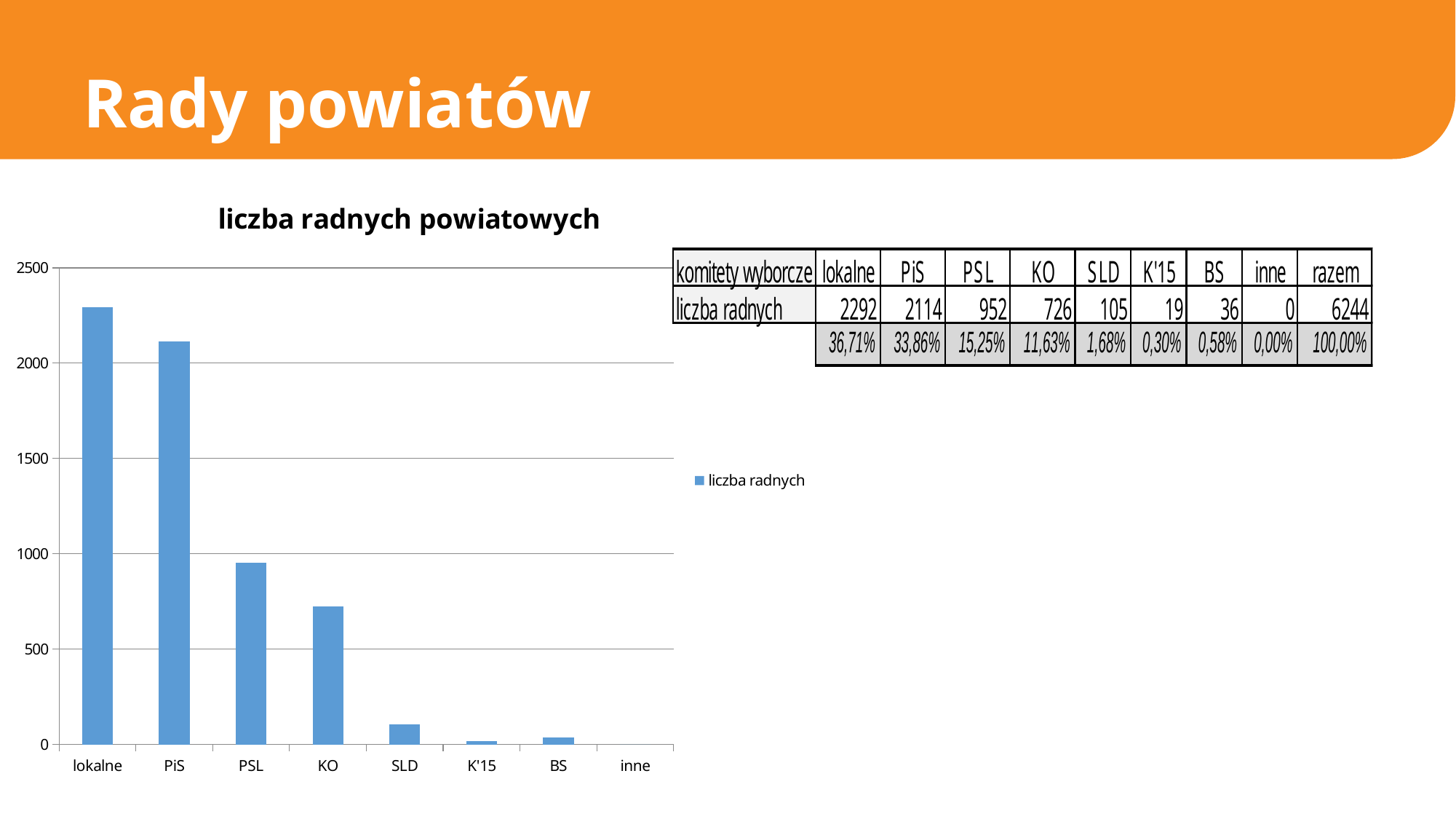
How many categories are shown on the x axis of the chart? 8 What kind of chart is shown on the slide? bar chart How many series does the chart legend list? 1 What is the title of the chart? liczba radnych powiatowych Which category has the highest bar in the chart? lokalne According to the table on the slide, what is the difference between the number of councillors for lokalne and PiS? 178 Do the bar values generally rise or fall from left to right across the first four categories? fall Is the value for PiS greater or less than 2000? greater Which category has the lowest value in the chart? inne Which is larger, the value for KO or the value for SLD? KO Is the value for PSL greater or less than 1000? less According to the table on the slide, how many councillors (liczba radnych) does PiS have? 2114